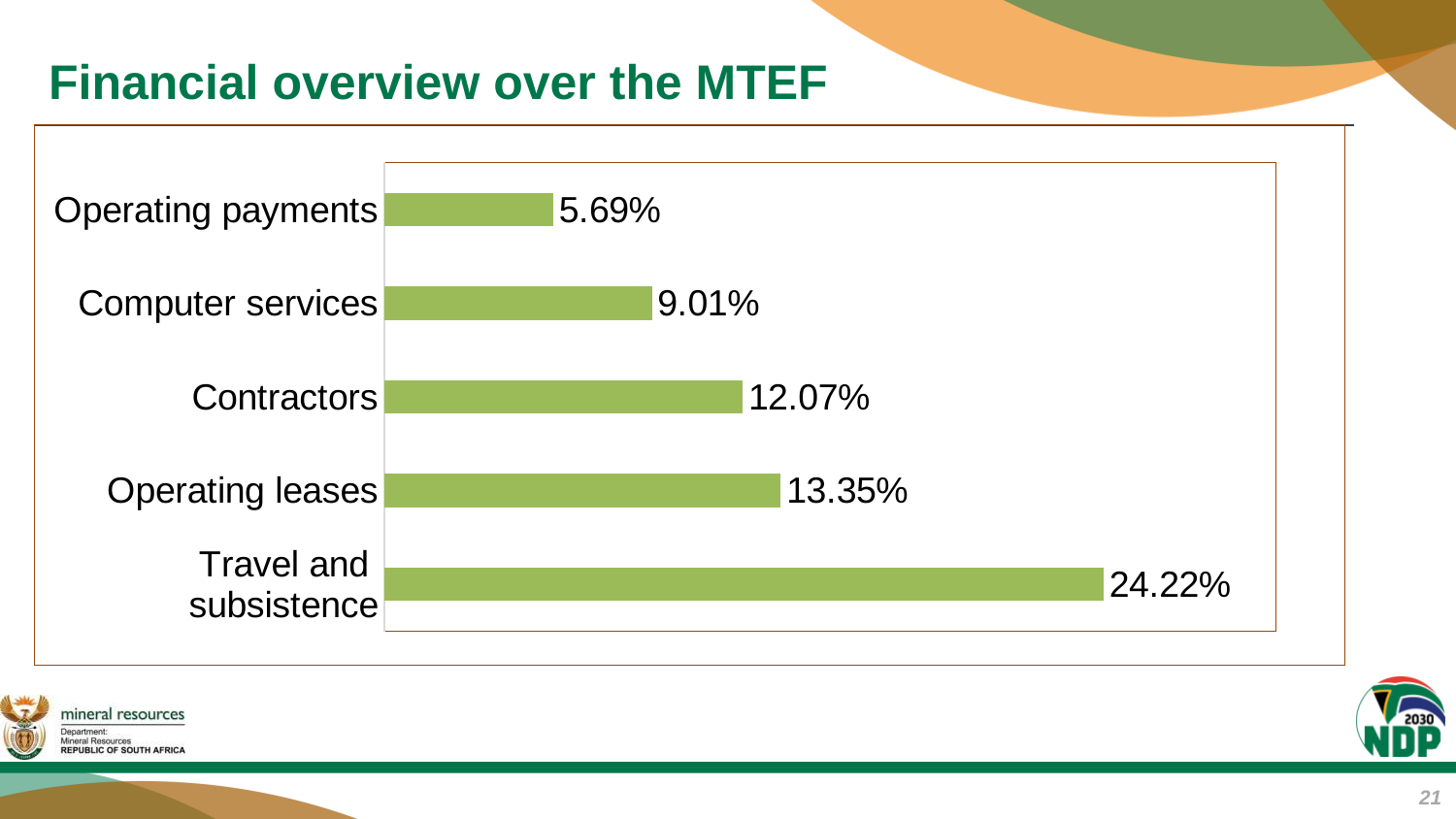
What is the value for Operating payments? 5.69% Which category has the highest value? Travel and subsistence How many categories are shown in the chart? 5 What is the difference between the values for Travel and subsistence and Operating leases? 10.87% Which category has the lowest value? Operating payments What is the value for Computer services? 9.01% What kind of chart is shown on the slide? Bar chart What is the value for Operating leases? 13.35% What is the value for Travel and subsistence? 24.22% What is the value for Contractors? 12.07% What is the title of the slide containing the chart? Financial overview over the MTEF Which is larger, the value for Contractors or the value for Computer services? Contractors